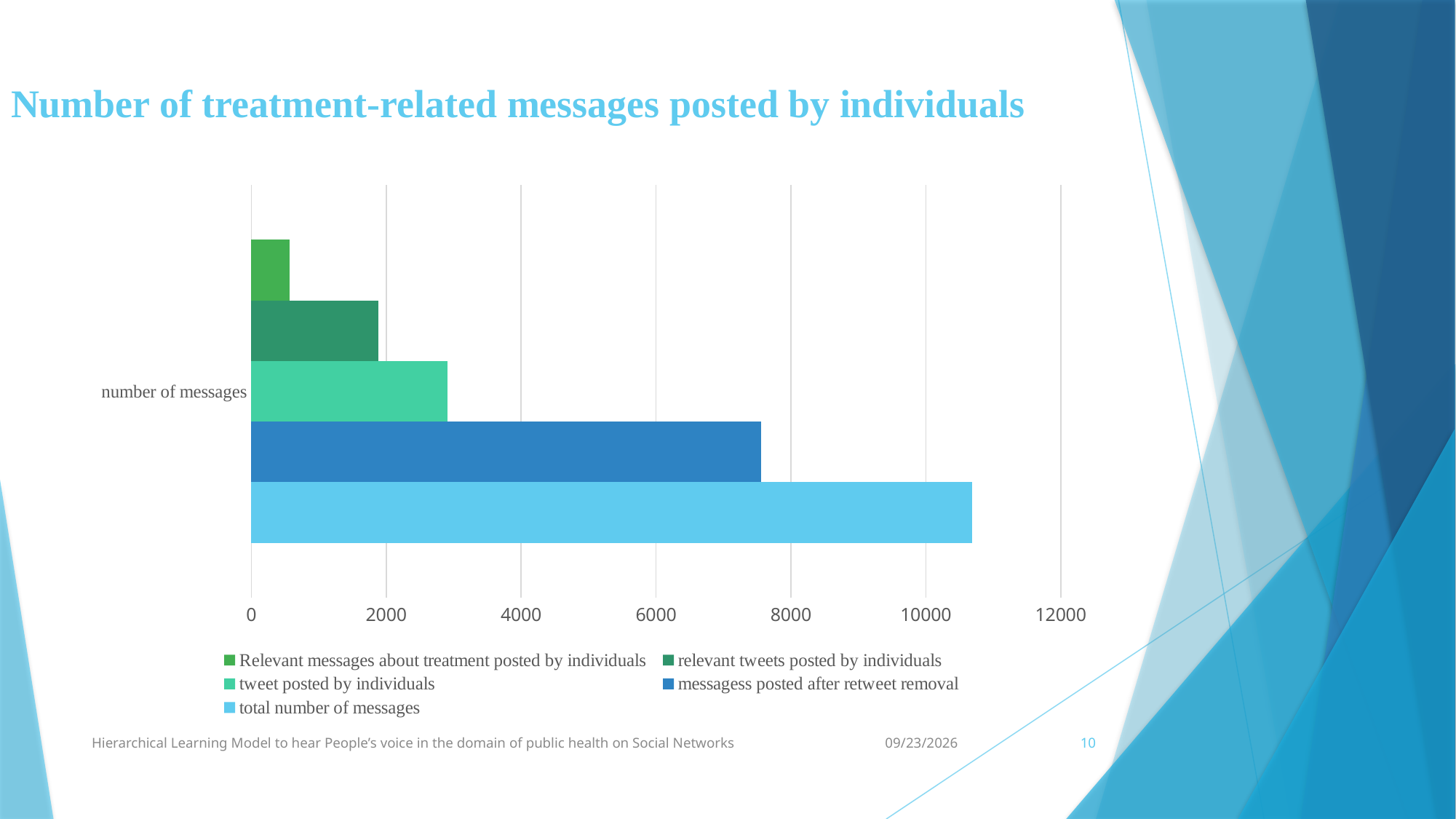
Which series has the shortest bar? Relevant messages about treatment posted by individuals Which is larger: messagess posted after retweet removal or tweet posted by individuals? messagess posted after retweet removal Is the value for total number of messages greater or less than 10000? greater Is the value for Relevant messages about treatment posted by individuals greater or less than 2000? less Which series has the longest bar? total number of messages What kind of chart is shown on the slide? bar chart Is the value for tweet posted by individuals greater or less than 2000? greater What is the label of the category on the vertical axis? number of messages How many categories are shown on the vertical axis? 1 What is the title of the chart on the slide? Number of treatment-related messages posted by individuals How many series does the legend list? 5